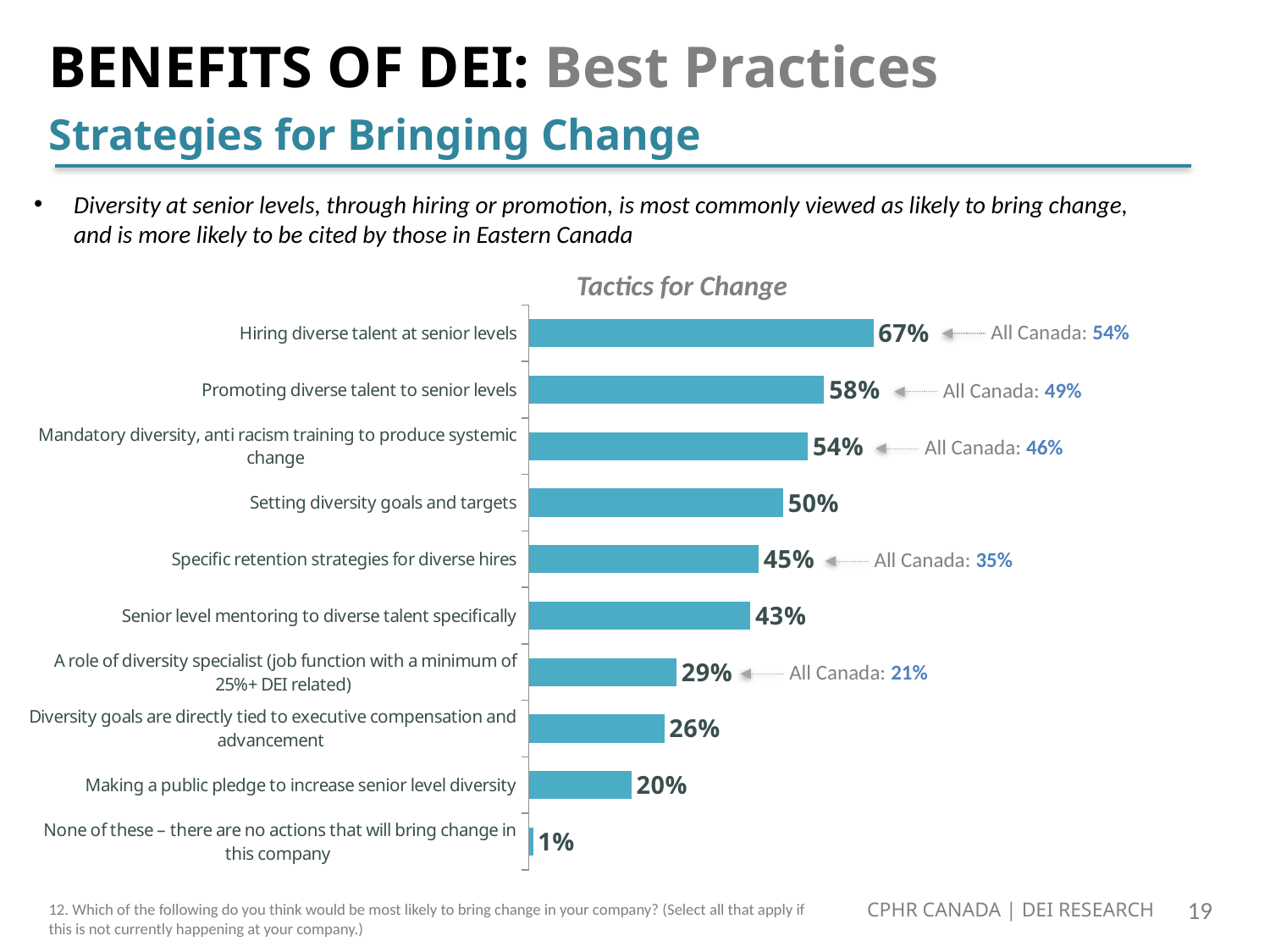
What is the title of the chart? Tactics for Change What is the difference between the chart value and the All Canada value for 'Hiring diverse talent at senior levels'? 13% What is the value for 'Making a public pledge to increase senior level diversity'? 20% How many categories are shown in the chart? 10 What is the difference between 'Promoting diverse talent to senior levels' and 'Senior level mentoring to diverse talent specifically'? 15% What is the value for 'Hiring diverse talent at senior levels'? 67% Which category has the lowest value? None of these – there are no actions that will bring change in this company Which category has the highest value? Hiring diverse talent at senior levels Which is larger: 'Specific retention strategies for diverse hires' or 'A role of diversity specialist (job function with a minimum of 25%+ DEI related)'? Specific retention strategies for diverse hires What is the All Canada value shown next to 'Mandatory diversity, anti racism training to produce systemic change'? 46% What is the value for 'Setting diversity goals and targets'? 50% What kind of chart is this? Bar chart